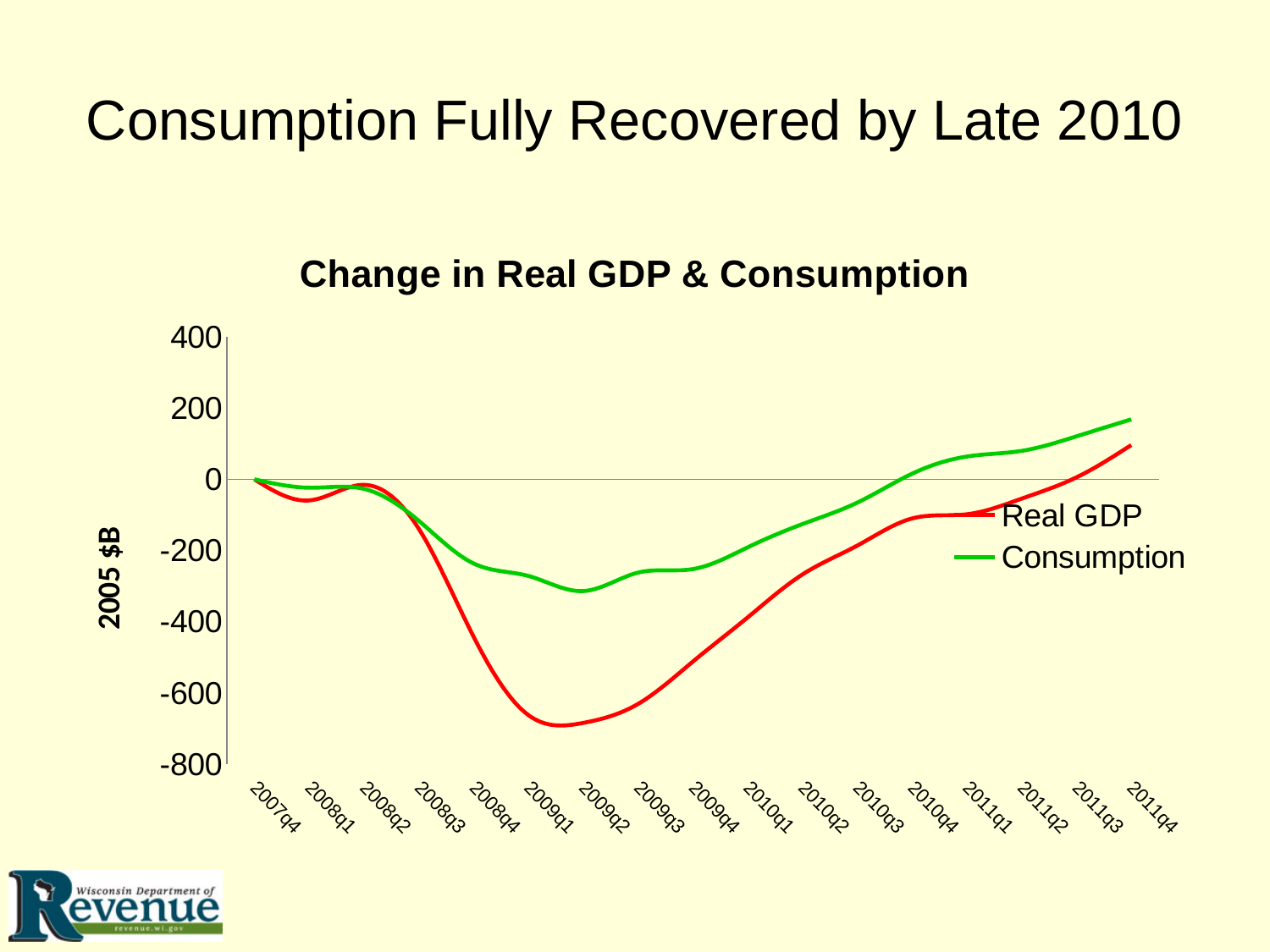
In which quarter does the Real GDP line reach its lowest value? 2009q2 Is the value for Real GDP at 2009q1 greater or less than -600? less Is the value for Real GDP at 2011q4 greater or less than 200? less At 2009q1, which series has the higher value, Real GDP or Consumption? Consumption How many quarters are plotted along the x axis? 17 In which quarter does the Consumption line reach its highest value? 2011q4 What kind of chart is shown on the slide? line chart Is the value for Consumption at 2011q4 greater or less than 100? greater Does the Real GDP line rise or fall from 2009q1 to 2011q4? rise How many series does the legend list? 2 What is the label on the vertical axis of the chart? 2005 $B